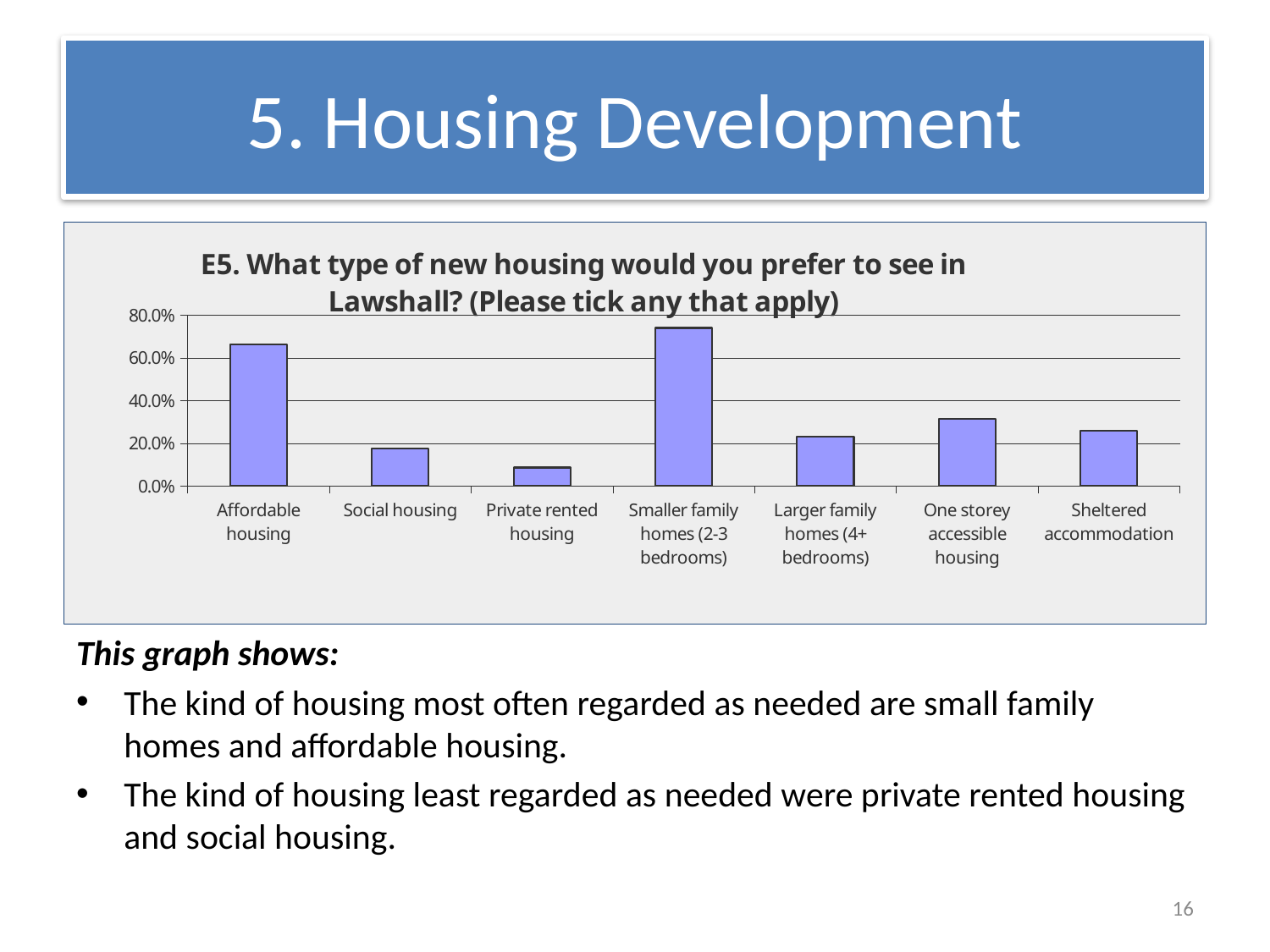
Which is larger, the value for Affordable housing or the value for Smaller family homes (2-3 bedrooms)? Smaller family homes (2-3 bedrooms) Is the value for Private rented housing greater or less than 20.0%? less Is the value for One storey accessible housing greater or less than 20.0%? greater Is the value for Smaller family homes (2-3 bedrooms) greater or less than 60.0%? greater Which housing type has the highest value in the chart? Smaller family homes (2-3 bedrooms) What kind of chart is shown on the slide? bar chart What is the title of the chart? E5. What type of new housing would you prefer to see in Lawshall? (Please tick any that apply) How many housing types are shown on the x axis of the chart? 7 Which housing type has the lowest value in the chart? Private rented housing Which is larger, the value for Social housing or the value for Private rented housing? Social housing